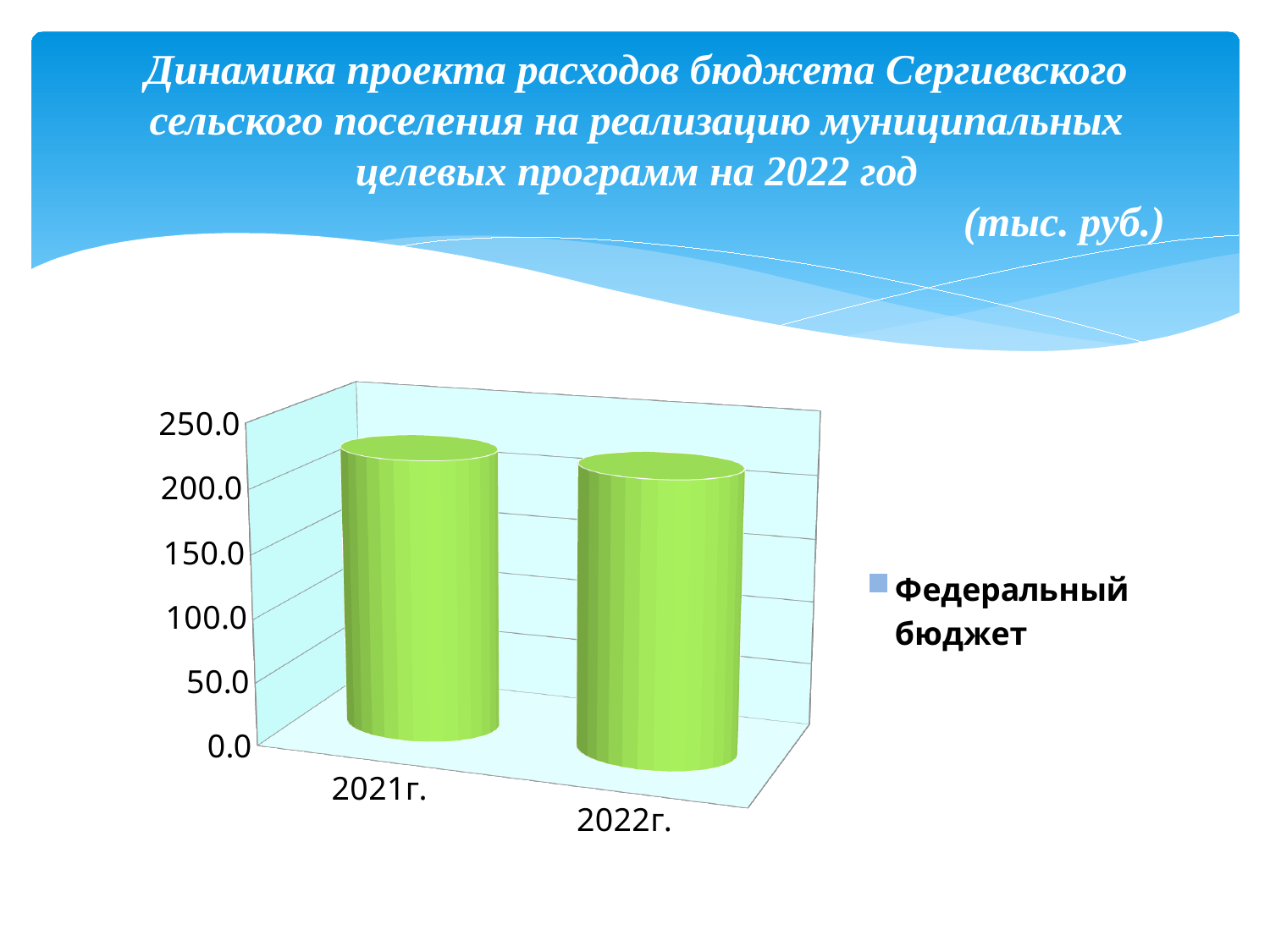
Is the value for 2021г. greater or less than 100? greater Is the value for 2022г. greater or less than 250? less Is the value for 2021г. greater or less than 150? greater What is the name of the series shown in the chart legend? Федеральный бюджет How many categories (years) are shown on the x axis of the chart? 2 What kind of chart is shown on the slide? bar chart Which years are shown as categories on the x axis of the chart? 2021г. and 2022г. What is the highest value shown on the vertical axis of the chart? 250.0 How many series does the chart legend list? 1